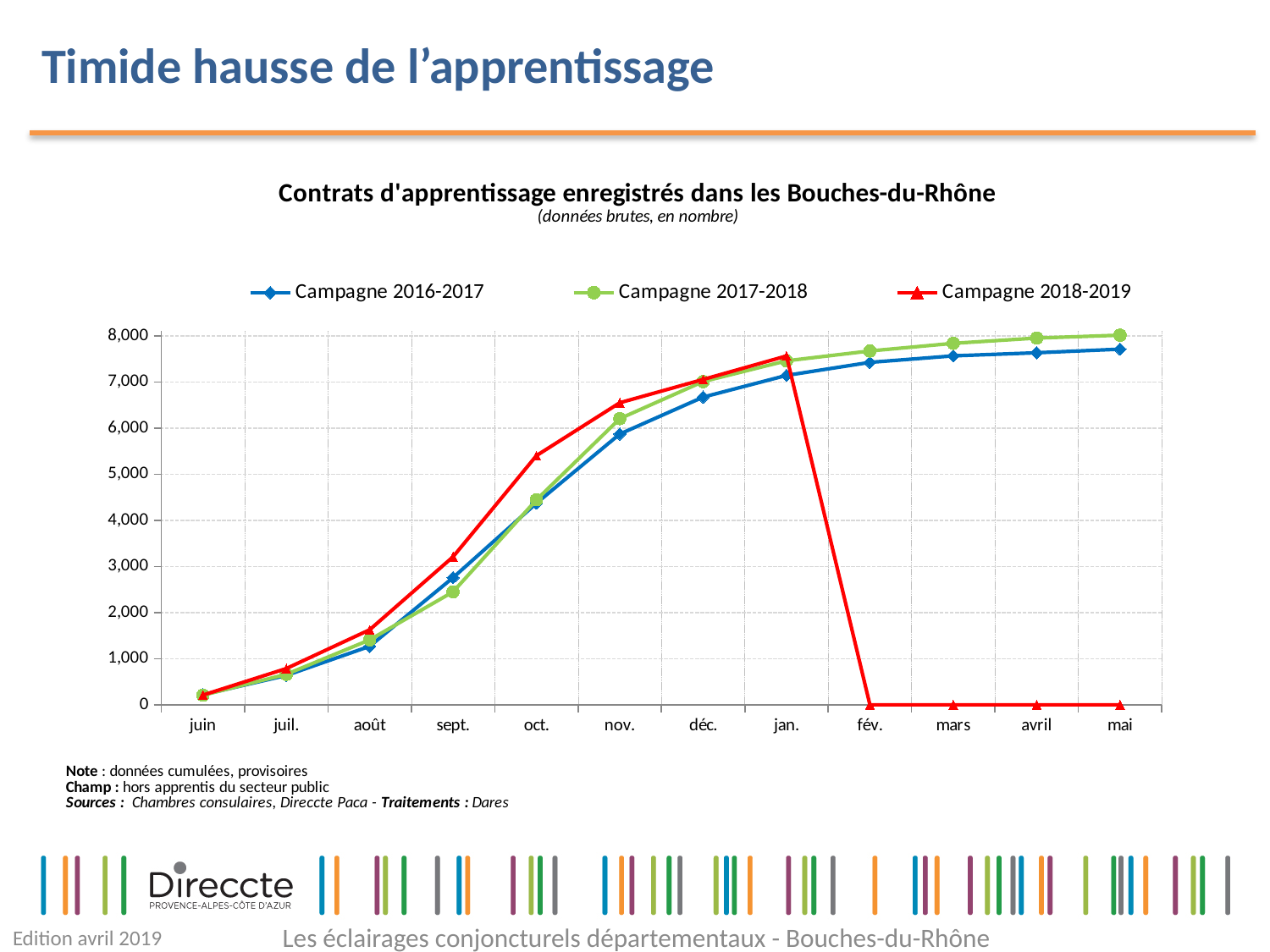
Is the value for Campagne 2016-2017 in mai greater or less than 8,000? less Is the value for Campagne 2018-2019 in sept. greater or less than 3,000? greater How many months are shown on the x axis? 12 What kind of chart is shown on the slide? line chart Which series is drawn in red with triangle markers? Campagne 2018-2019 In nov., which series has the larger value: Campagne 2018-2019 or Campagne 2016-2017? Campagne 2018-2019 Is the value for Campagne 2017-2018 in oct. greater or less than 4,000? greater What is the value for Campagne 2018-2019 in mars? 0 Do the values for Campagne 2016-2017 rise or fall from juin to mai? rise In which month does Campagne 2017-2018 reach its highest value? mai How many series does the legend list? 3 In sept., which series has the larger value: Campagne 2017-2018 or Campagne 2018-2019? Campagne 2018-2019